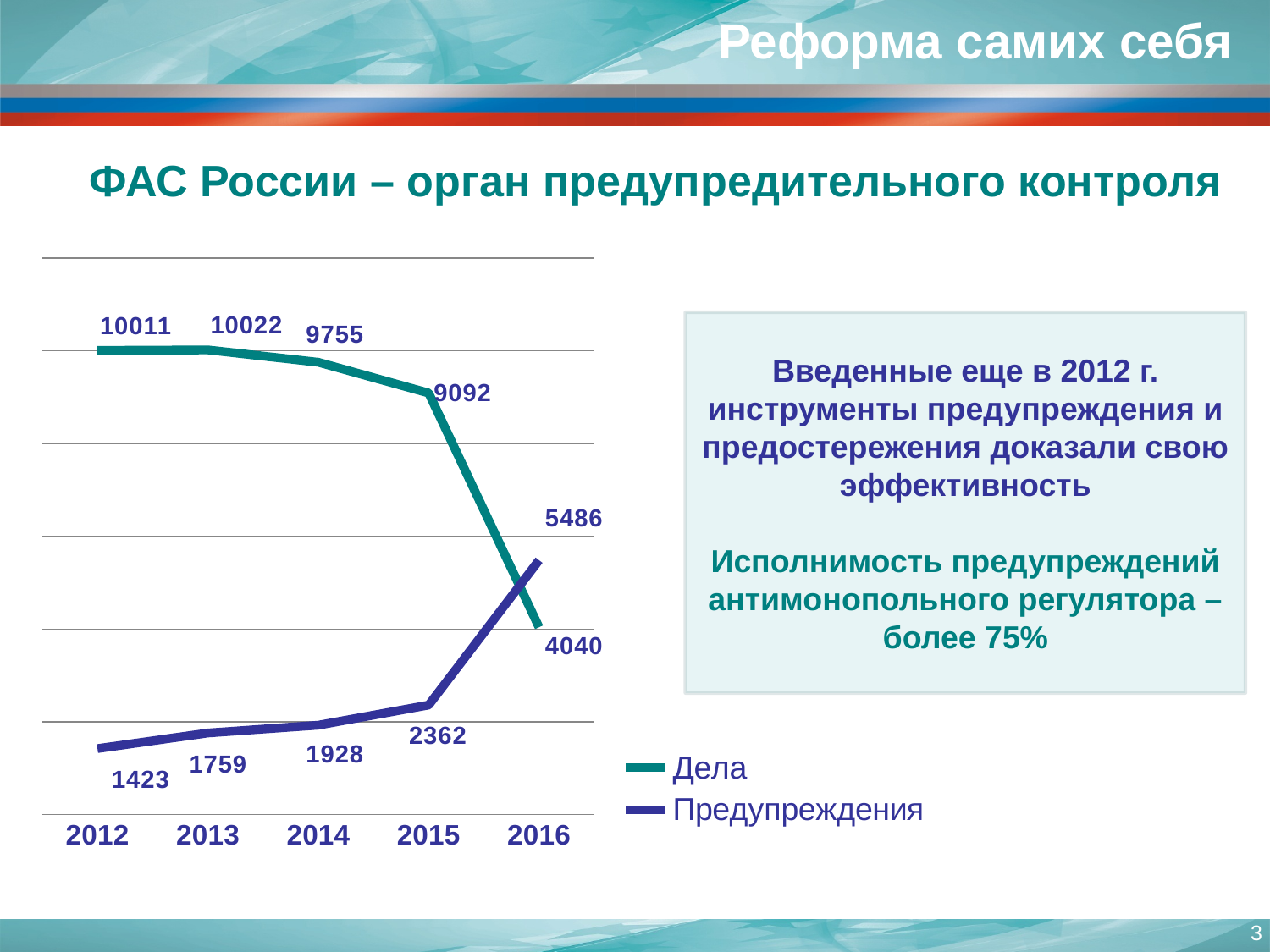
Does the Предупреждения series rise or fall from 2012 to 2016? rise What is the value for Предупреждения in 2016? 5486 Which is larger in 2016, Дела or Предупреждения? Предупреждения What is the value for Предупреждения in 2014? 1928 What is the value for Дела in 2012? 10011 In which year is the value for Предупреждения lowest? 2012 How many years are shown on the x axis? 5 In which year is the value for Дела highest? 2013 How many series does the chart legend list? 2 What type of chart is shown on the slide? line chart What is the value for Дела in 2016? 4040 What is the difference between the Дела values for 2015 and 2016? 5052